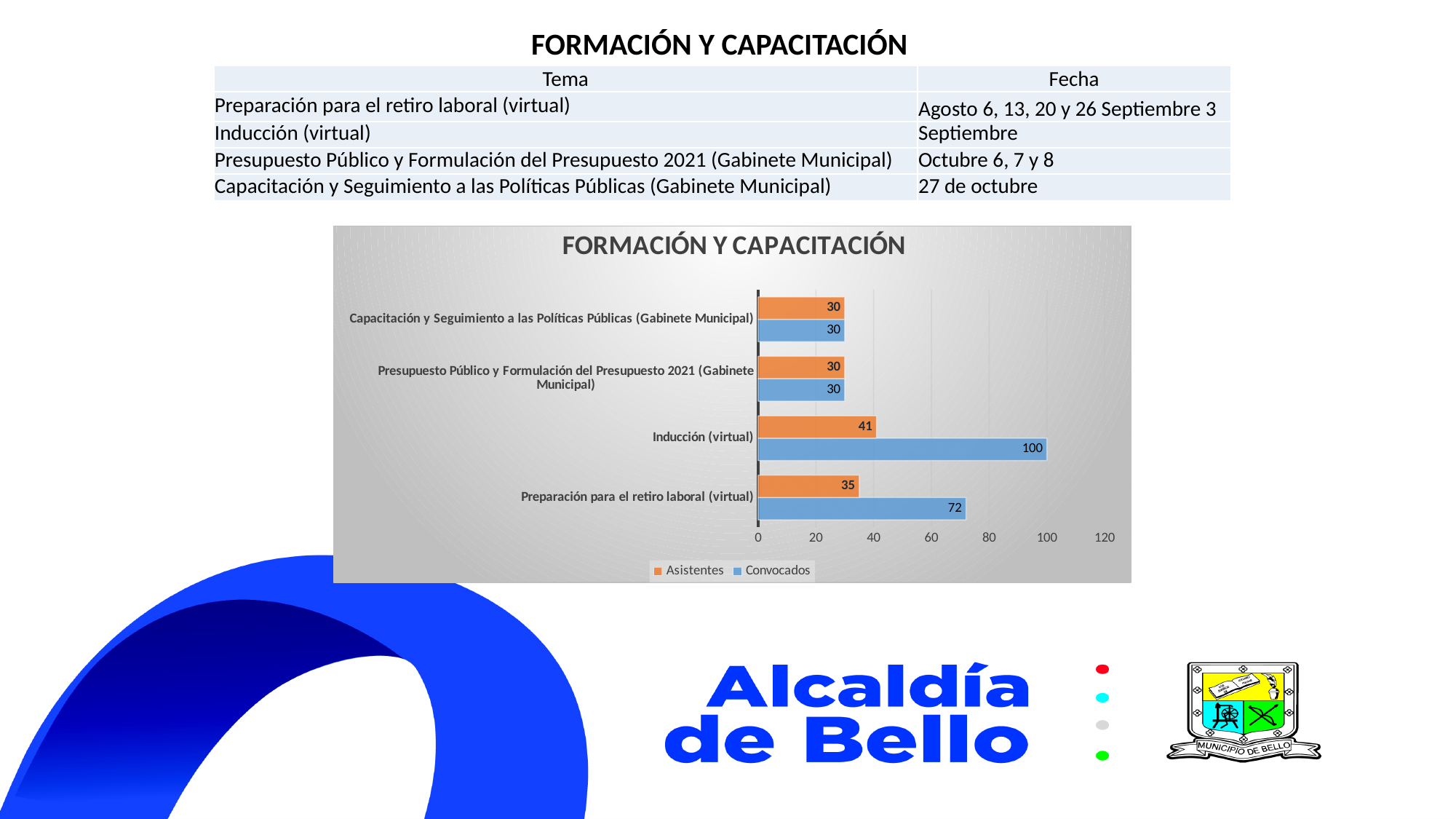
What kind of chart is shown on the slide? Bar chart What is the Asistentes value for Preparación para el retiro laboral (virtual)? 35 What is the Convocados value for Inducción (virtual)? 100 What is the Asistentes value for Inducción (virtual)? 41 Which category has the lowest Asistentes value, Inducción (virtual) or Preparación para el retiro laboral (virtual)? Preparación para el retiro laboral (virtual) How many categories are shown on the chart? 4 What is the difference between Convocados and Asistentes for Preparación para el retiro laboral (virtual)? 37 What is the title of the chart? FORMACIÓN Y CAPACITACIÓN Which category has the highest Convocados value? Inducción (virtual) What is the Convocados value for Preparación para el retiro laboral (virtual)? 72 What is the difference between Convocados and Asistentes for Inducción (virtual)? 59 How many series does the legend list? 2